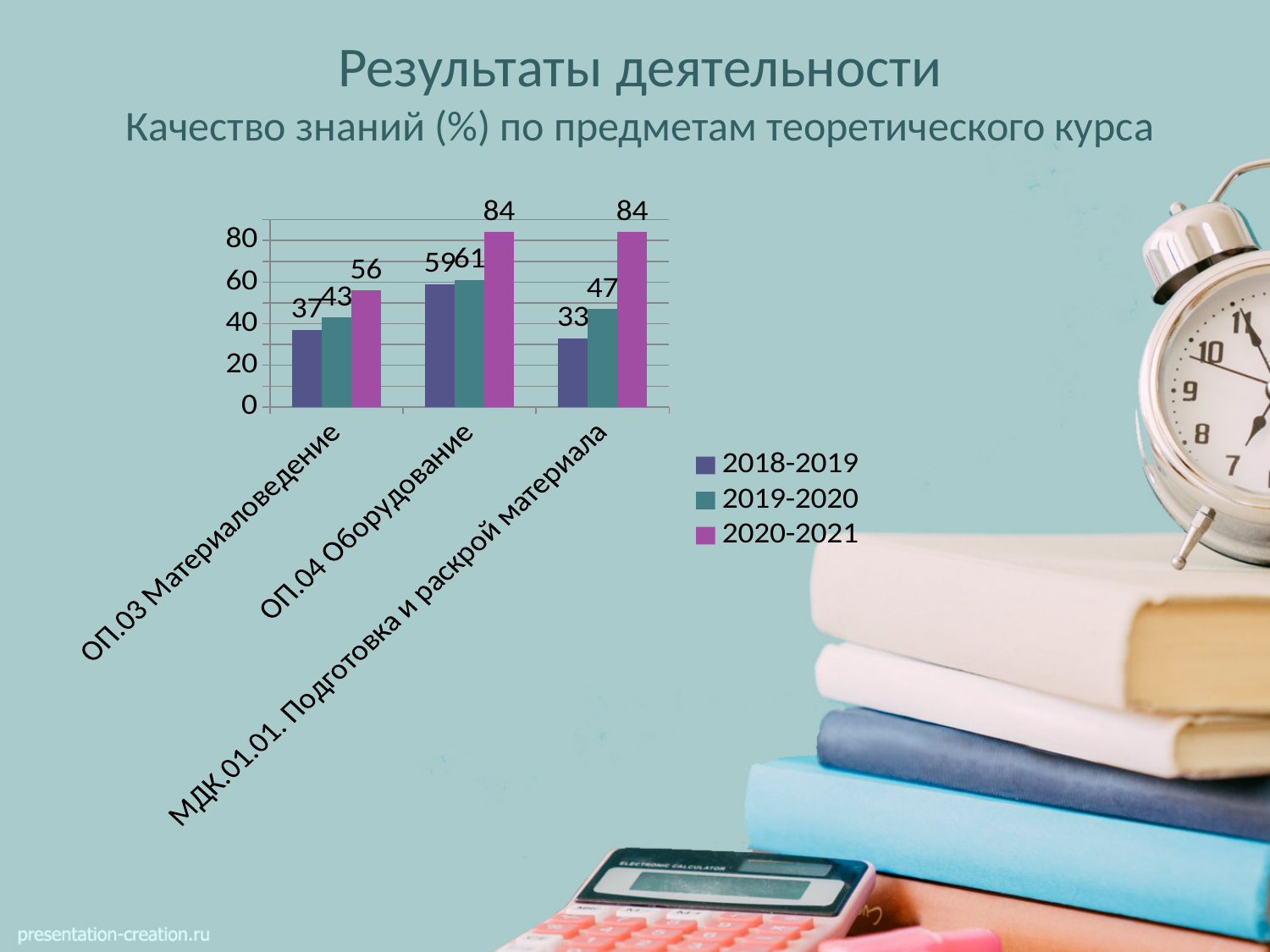
How many series does the legend list? 3 What is the value for МДК.01.01. Подготовка и раскрой материала in the 2019-2020 series? 47 What is the difference between the 2020-2021 and 2018-2019 values for МДК.01.01. Подготовка и раскрой материала? 51 What kind of chart is shown on the slide? bar chart Do the values for ОП.04 Оборудование rise or fall from 2018-2019 to 2020-2021? rise Which category has the lowest value in the 2018-2019 series? МДК.01.01. Подготовка и раскрой материала How many categories are shown on the x axis? 3 What is the difference between the 2019-2020 and 2018-2019 values for ОП.03 Материаловедение? 6 What is the value for ОП.03 Материаловедение in the 2020-2021 series? 56 What is the value for ОП.04 Оборудование in the 2018-2019 series? 59 Which is larger: the 2020-2021 value for ОП.03 Материаловедение or the 2018-2019 value for ОП.04 Оборудование? 2018-2019 value for ОП.04 Оборудование Which category has the highest value in the 2019-2020 series? ОП.04 Оборудование